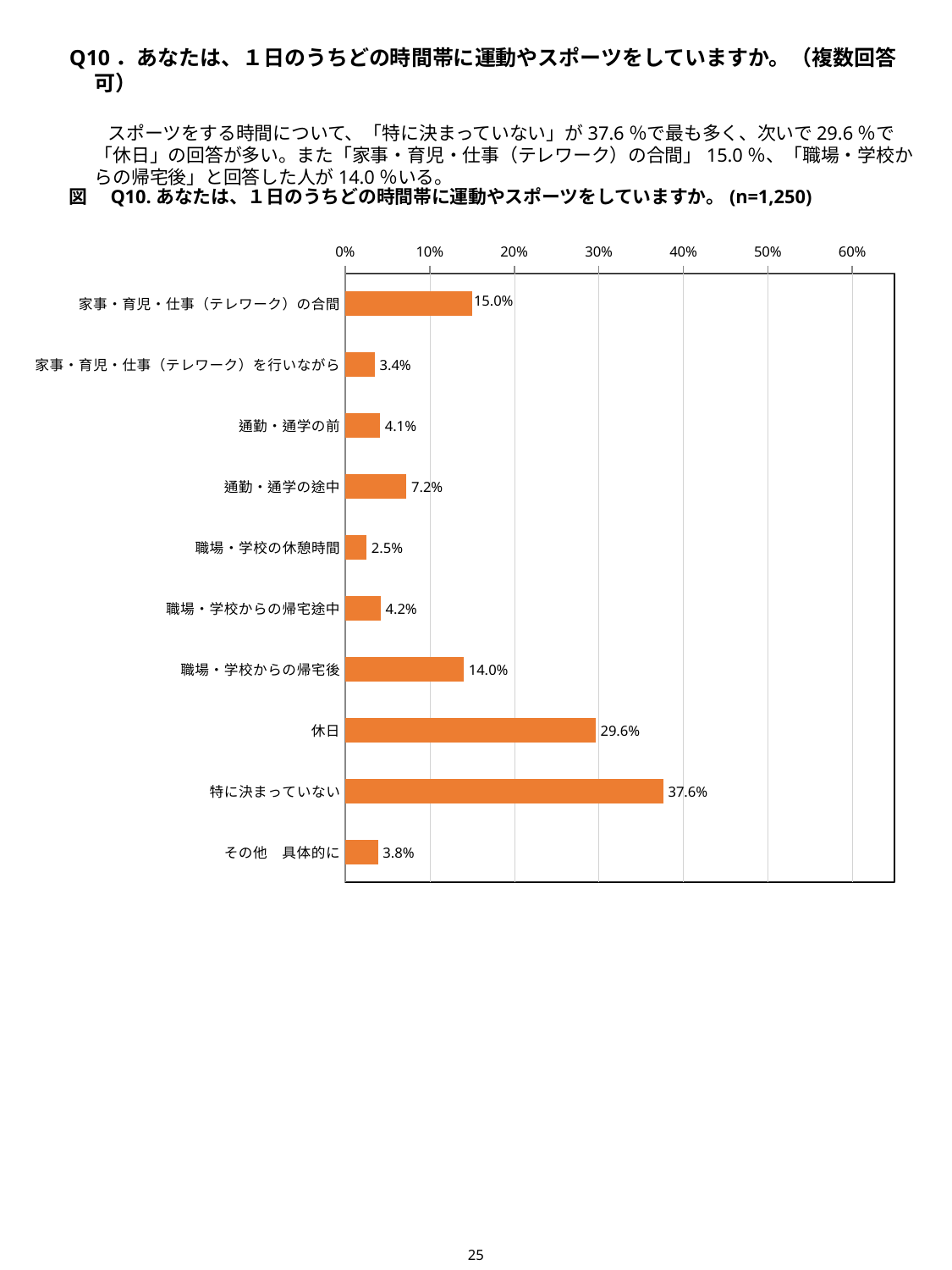
What is the difference between the values for 家事・育児・仕事（テレワーク）の合間 and 職場・学校からの帰宅後? 1.0% What is the value for 通勤・通学の途中? 7.2% Which category has the highest value? 特に決まっていない What is the sample size (n) stated in the chart title? 1,250 How many categories are shown in the chart? 10 Is the value for 休日 greater or less than 20%? greater Which is larger, the value for 通勤・通学の途中 or the value for 通勤・通学の前? 通勤・通学の途中 What kind of chart is shown on the slide? bar chart What is the difference between the values for 特に決まっていない and 休日? 8.0% Which category has the lowest value? 職場・学校の休憩時間 What is the value for 職場・学校からの帰宅後? 14.0% What is the value for 特に決まっていない? 37.6%